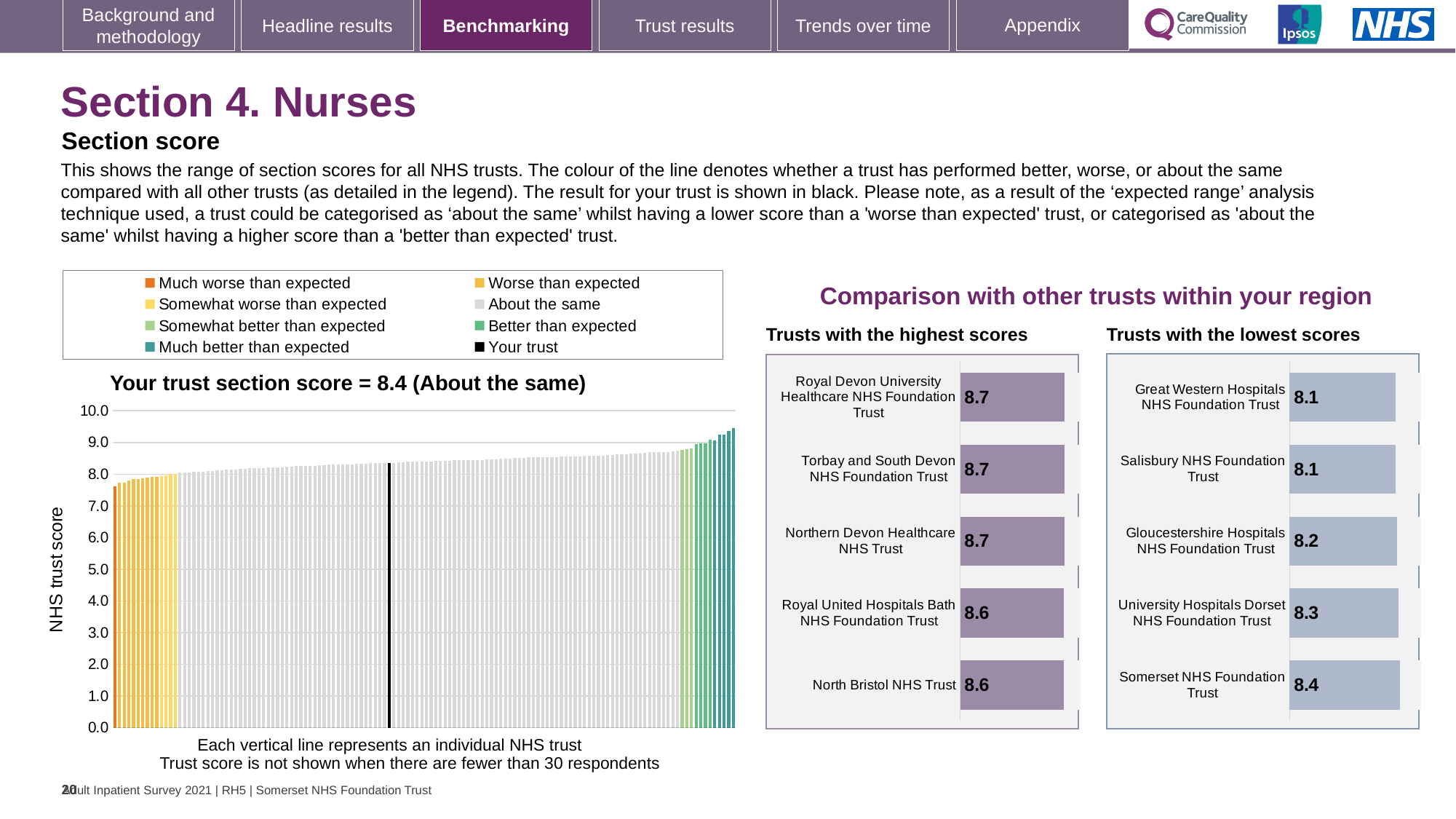
In the 'Trusts with the lowest scores' chart, which trust has the highest score? Somerset NHS Foundation Trust How many entries does the legend of the main section score chart on the left list? 8 In the main section score chart on the left, do the trust scores rise or fall from left to right? Rise In the 'Trusts with the highest scores' chart, what is the score for Torbay and South Devon NHS Foundation Trust? 8.7 In the 'Trusts with the lowest scores' chart, which has the larger score: Gloucestershire Hospitals NHS Foundation Trust or University Hospitals Dorset NHS Foundation Trust? University Hospitals Dorset NHS Foundation Trust In the main section score chart on the left, is the value of the lowest-scoring trust (leftmost bar) greater or less than 7.0? greater What kind of chart is the main section score chart on the left? Bar chart In the 'Trusts with the highest scores' chart, what is the score for North Bristol NHS Trust? 8.6 In the 'Trusts with the lowest scores' chart, what is the difference between the scores of Somerset NHS Foundation Trust and Great Western Hospitals NHS Foundation Trust? 0.3 In the 'Trusts with the lowest scores' chart, what is the score for Gloucestershire Hospitals NHS Foundation Trust? 8.2 How many trusts are listed in the 'Trusts with the highest scores' chart? 5 In the main section score chart on the left, what is the section score for your trust, as stated in the chart title? 8.4